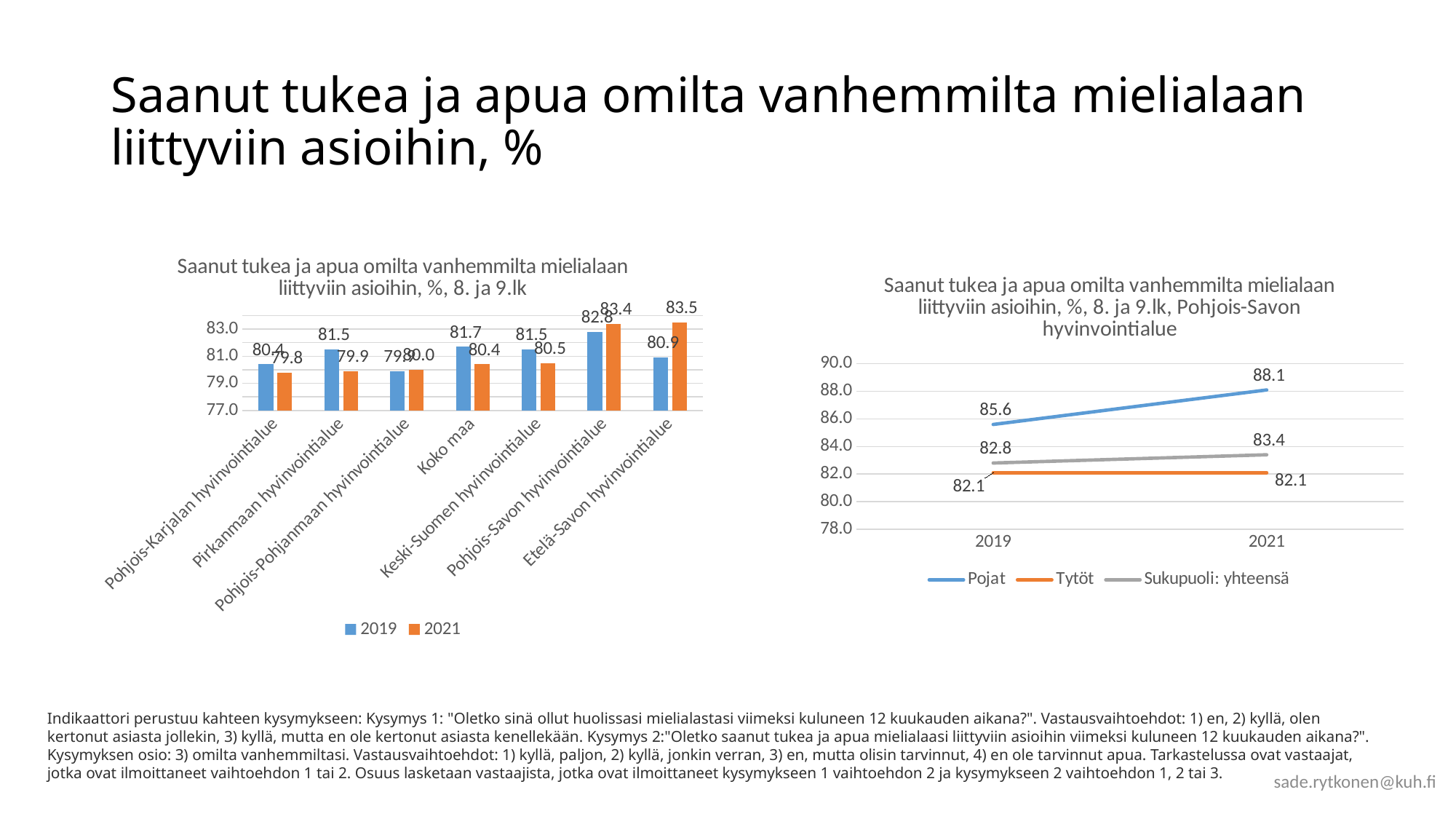
In the right line chart, how many series does the legend list? 3 What kind of chart is the left chart, titled 'Saanut tukea ja apua omilta vanhemmilta mielialaan liittyviin asioihin, %, 8. ja 9.lk'? bar chart How many categories are shown on the x axis of the left bar chart? 7 In the left bar chart, which category has the highest 2019 value? Pohjois-Savon hyvinvointialue What kind of chart is the right chart about Pohjois-Savon hyvinvointialue? line chart In the left bar chart, what is the 2019 value for Koko maa? 81.7 In the right line chart, what is the value for Pojat in 2021? 88.1 In the left bar chart, by how much did the value for Pohjois-Savon hyvinvointialue increase from 2019 to 2021? 0.6 In the left bar chart, is the 2019 or the 2021 value larger for Pirkanmaan hyvinvointialue? 2019 How many series does the legend of the left bar chart list? 2 In the left bar chart, what is the 2021 value for Etelä-Savon hyvinvointialue? 83.5 In the right line chart, what is the difference between the Pojat values in 2021 and 2019? 2.5